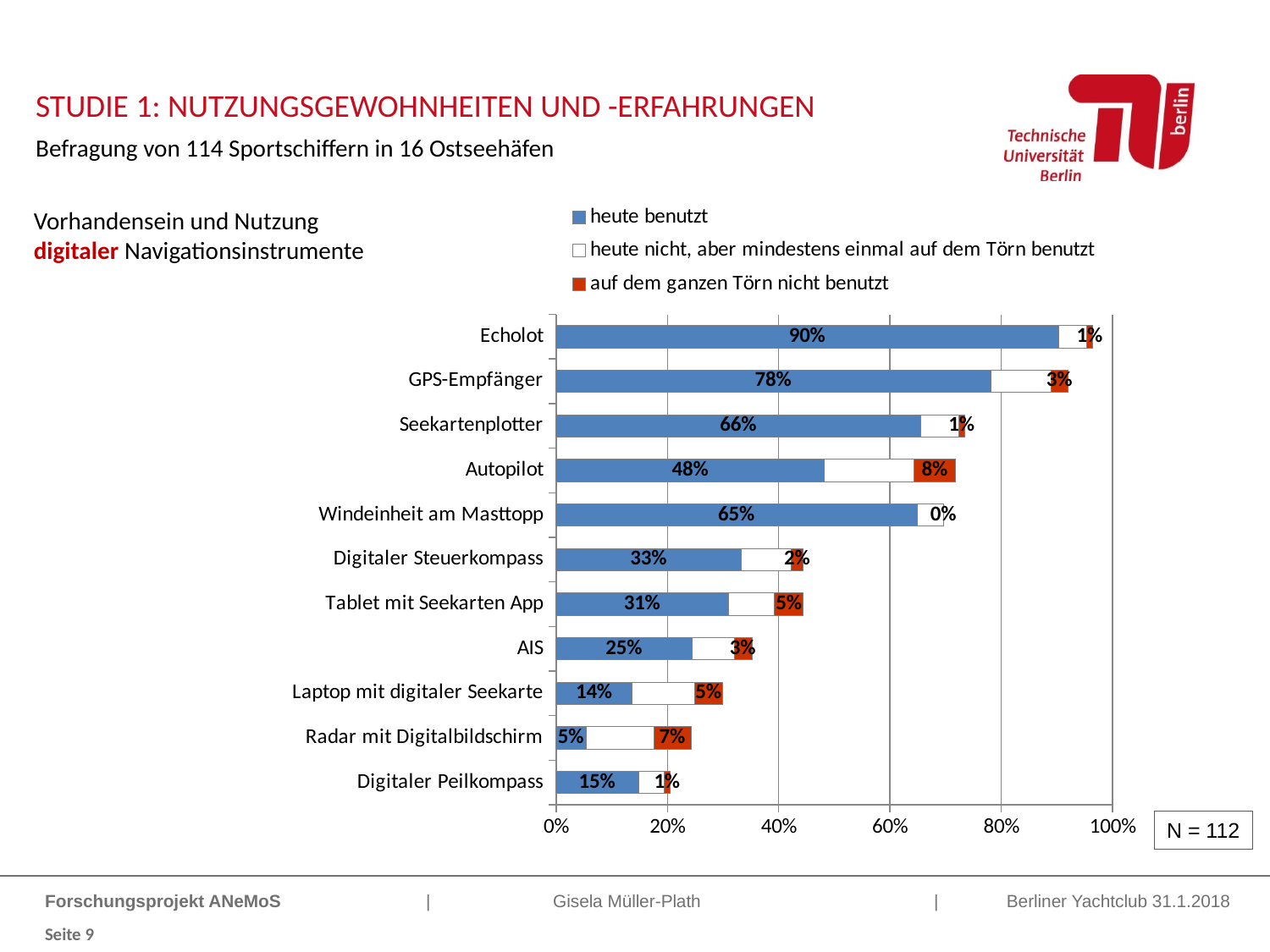
How many navigation instruments (categories) are shown in the chart? 11 Which instrument has the lowest 'heute benutzt' value? Radar mit Digitalbildschirm What kind of chart is shown on the slide? bar chart How many series does the legend list? 3 Which instrument has the highest 'auf dem ganzen Törn nicht benutzt' value? Autopilot What colour represents the series 'heute benutzt' in the chart? blue Which has a larger 'heute benutzt' value, Tablet mit Seekarten App or AIS? Tablet mit Seekarten App Which instrument has the highest 'heute benutzt' value? Echolot What is the difference between the 'heute benutzt' values for GPS-Empfänger and Seekartenplotter? 12% What is the 'heute benutzt' value for Autopilot? 48% What is the 'auf dem ganzen Törn nicht benutzt' value for Radar mit Digitalbildschirm? 7% What is the 'heute benutzt' value for Echolot? 90%